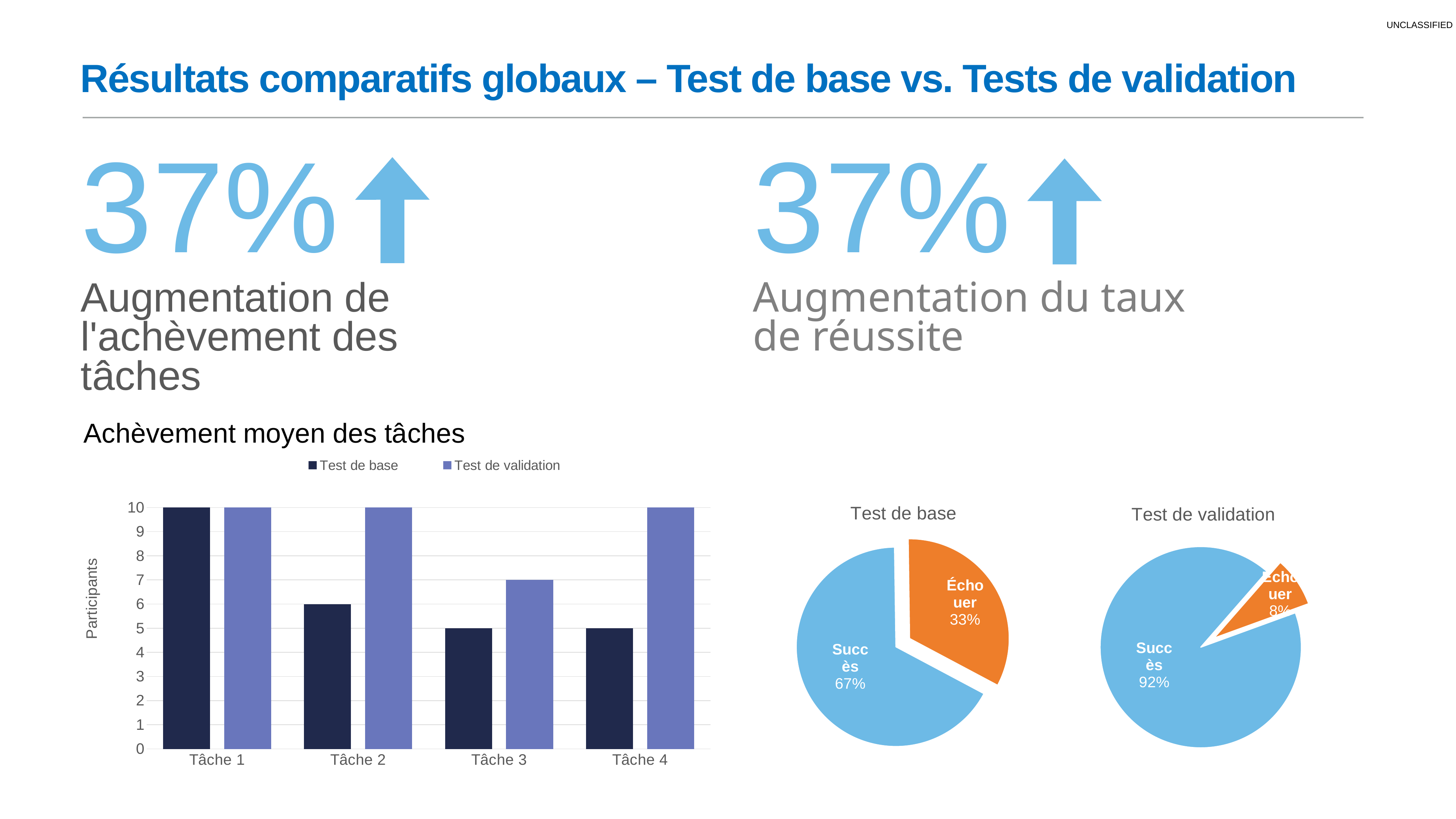
In the 'Achèvement moyen des tâches' chart, which task has the lowest Test de validation value? Tâche 3 In the 'Achèvement moyen des tâches' chart, what is the Test de base value for Tâche 4? 5 What kind of chart is 'Achèvement moyen des tâches'? Bar chart How many tasks are shown on the x axis of the 'Achèvement moyen des tâches' chart? 4 In the 'Test de validation' pie chart, what share is labelled Succès? 92% In the 'Achèvement moyen des tâches' chart, which is larger for Tâche 4: Test de base or Test de validation? Test de validation In the 'Test de base' pie chart, what share is labelled Échouer? 33% In the 'Achèvement moyen des tâches' chart, what is the Test de base value for Tâche 2? 6 In the 'Achèvement moyen des tâches' chart, what is the difference between the Test de validation and Test de base values for Tâche 2? 4 In the 'Achèvement moyen des tâches' chart, what is the Test de validation value for Tâche 3? 7 How many series does the legend of the 'Achèvement moyen des tâches' chart list? 2 What is the label of the y axis of the 'Achèvement moyen des tâches' chart? Participants